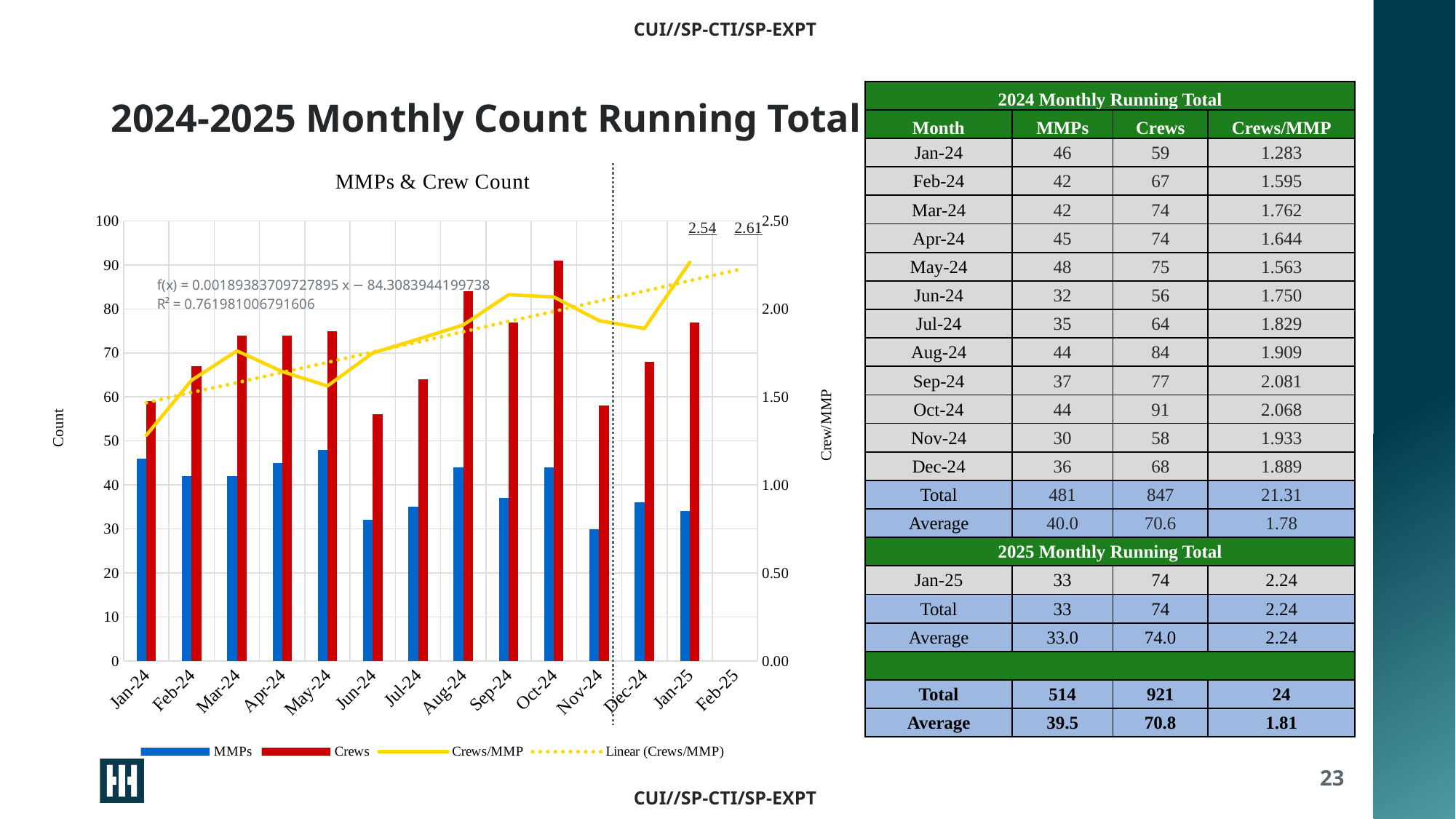
What colour are the Crews bars in the chart? Red How many months have bars plotted in the chart? 13 Which is larger in the chart, the Crews bar for Oct-24 or the Crews bar for Aug-24? Oct-24 Is the Crews value for Aug-24 greater or less than 80? greater How many series does the chart legend list? 4 Which month has the tallest Crews bar in the chart? Oct-24 What is the title of the chart? MMPs & Crew Count According to the table on the slide, what is the Crews/MMP value for Sep-24? 2.081 Is the MMPs value for Jun-24 greater or less than 40? less What kind of chart is shown on the slide? A bar chart with a line series According to the table on the slide, what is the difference between Crews and MMPs for Oct-24? 47 Does the dotted Linear (Crews/MMP) trendline rise or fall from left to right? Rise